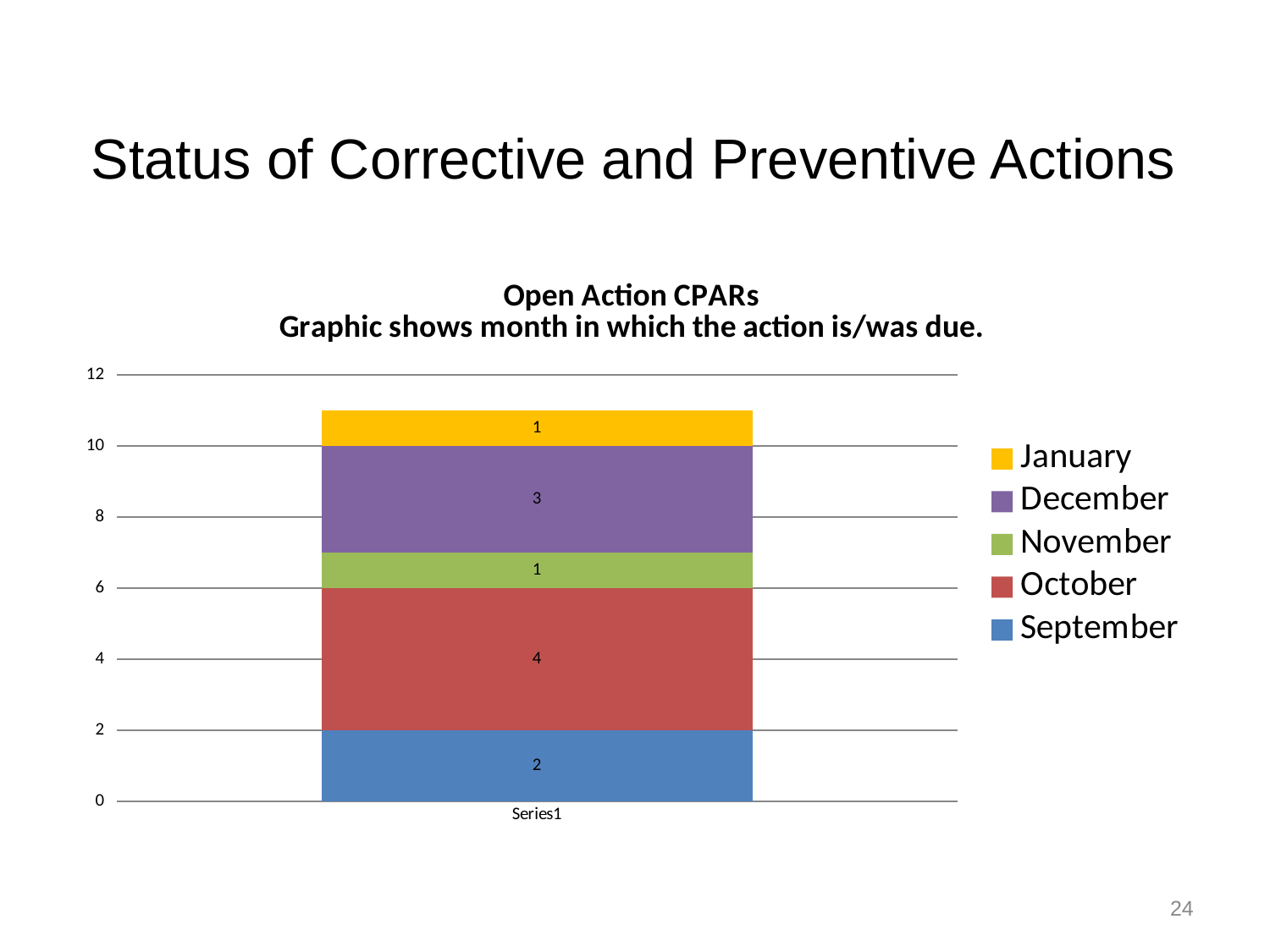
How many series does the legend list? 5 Is the total height of the stacked bar greater or less than 10? greater What is the value for October in the stacked bar? 4 What kind of chart is shown on the slide? Stacked bar chart What colour represents November in the chart? Green Which is larger, the value for September or the value for December? December What is the total of the stacked bar? 11 What is the difference between the October and December values? 1 Which month has the highest value in the stacked bar? October What is the value for January in the stacked bar? 1 What is the value for September in the stacked bar? 2 What is the value for December in the stacked bar? 3